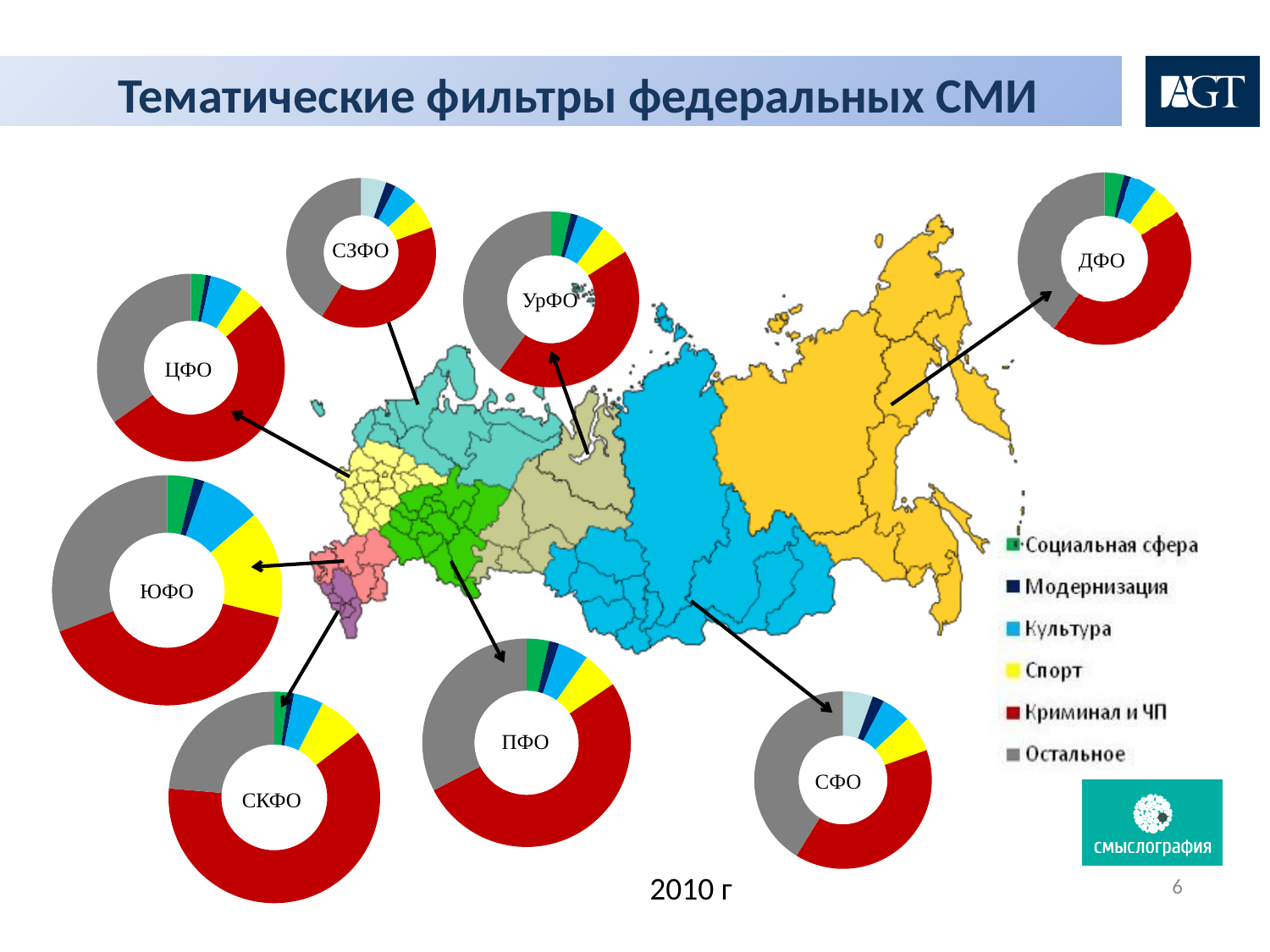
How many pie charts are shown on the slide? 8 In the ЮФО chart, which category has the largest share? Криминал и ЧП In the СКФО chart, which category has the largest share? Криминал и ЧП In the ЦФО chart, which is larger: Криминал и ЧП or Спорт? Криминал и ЧП What kind of chart is used to show the thematic breakdown for each federal district? pie (donut) chart Which colour represents Криминал и ЧП in the legend? red In the ЮФО chart, which is larger: Спорт or Культура? Спорт What is the title of the slide? Тематические фильтры федеральных СМИ Which federal district's chart shows the largest share for Спорт? ЮФО In the ЦФО chart, which category has the largest share? Криминал и ЧП How many categories does the legend list? 6